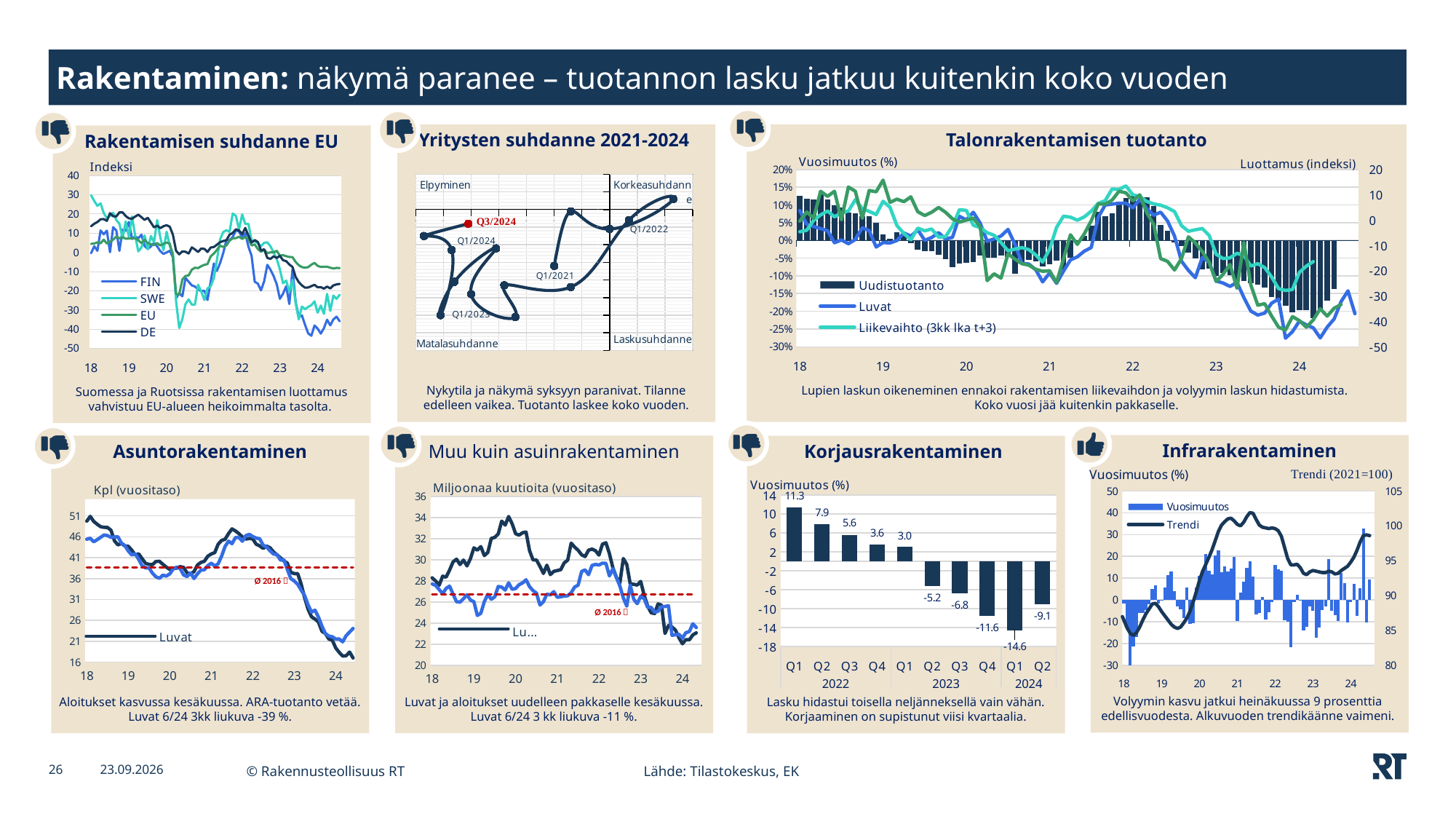
How many series does the legend of the Talonrakentamisen tuotanto chart list? 3 In the Korjausrakentaminen chart, what is the difference between the values for Q1 2022 and Q2 2022? 3.4 How many series does the legend of the Rakentamisen suhdanne EU chart list? 4 In the Korjausrakentaminen chart, what is the value for Q1 2022? 11.3 In the Korjausrakentaminen chart, which is larger: the value for Q2 2024 or the value for Q3 2023? Q3 2023 In the Korjausrakentaminen chart, which quarter has the highest value? Q1 2022 In the Korjausrakentaminen chart, which quarter has the lowest value? Q1 2024 In the Infrarakentaminen chart, what are the two legend entries? Vuosimuutos, Trendi In the Korjausrakentaminen chart, do the values rise or fall from Q1 2022 to Q1 2023? Fall What kind of chart is the Korjausrakentaminen chart? Bar chart How many bars are plotted in the Korjausrakentaminen chart? 10 In the Korjausrakentaminen chart, what is the value for Q4 2023? -11.6